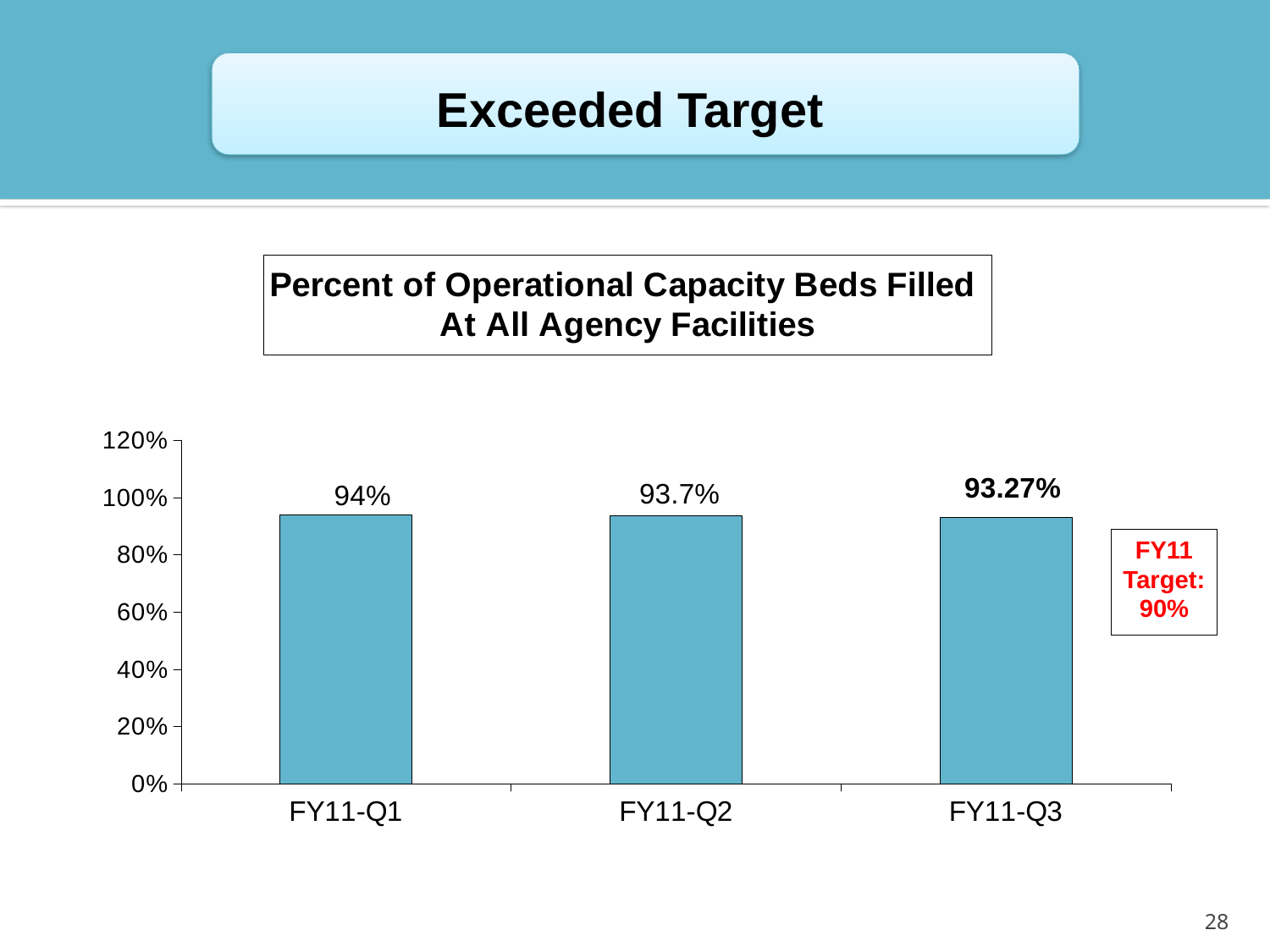
What is the value for FY11-Q1? 94% What kind of chart is shown on the slide? bar chart What is the value for FY11-Q2? 93.7% What is the value for FY11-Q3? 93.27% Which is larger, the value for FY11-Q2 or FY11-Q3? FY11-Q2 What is the FY11 target shown next to the chart? 90% Is the value for FY11-Q2 greater or less than 80%? greater Which quarter has the highest value? FY11-Q1 Do the values rise or fall from FY11-Q1 to FY11-Q3? fall Which quarter has the lowest value? FY11-Q3 How many quarters are shown on the chart? 3 What is the difference between the values for FY11-Q1 and FY11-Q3? 0.73%